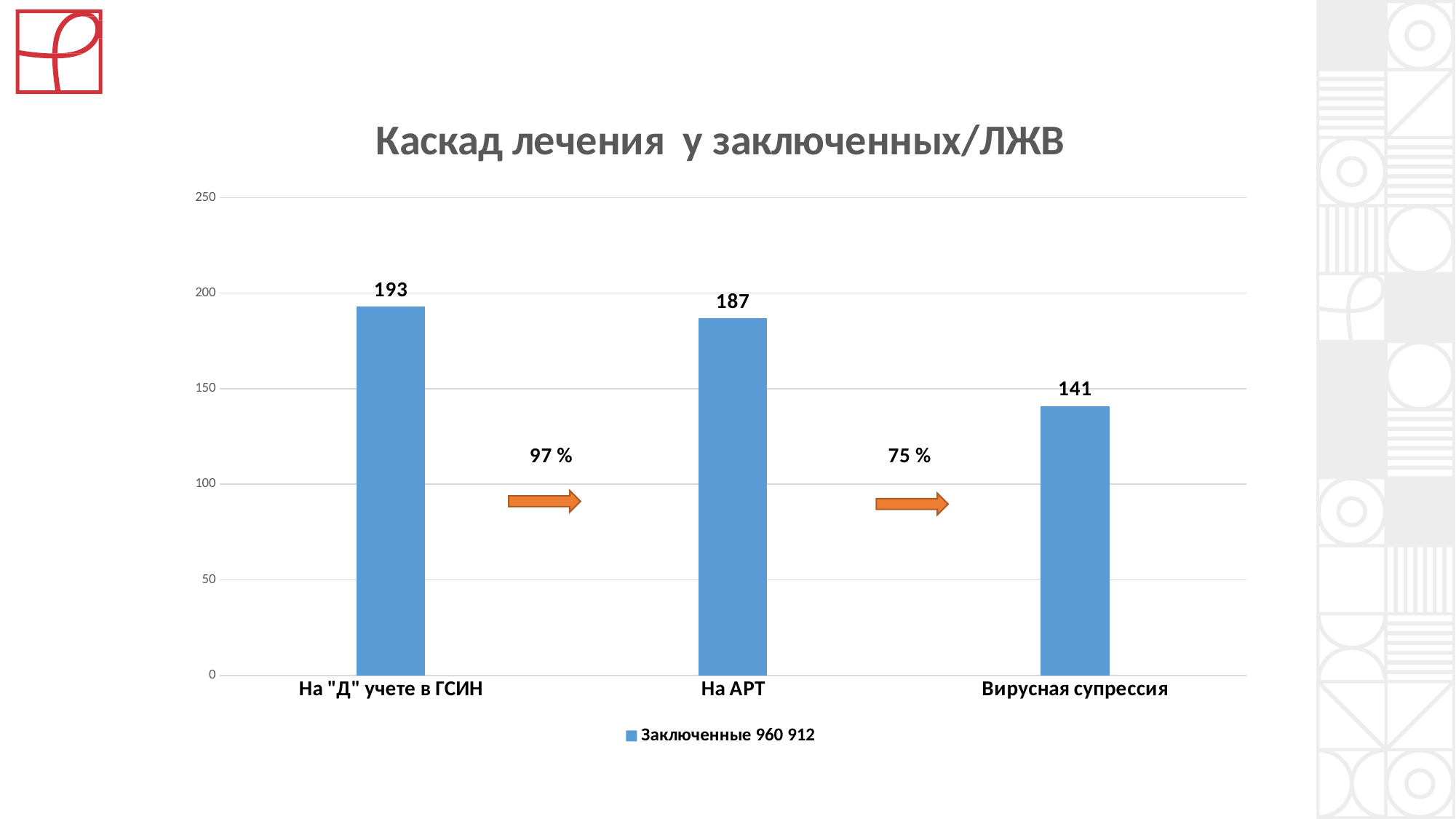
Which category has the lowest value? Вирусная супрессия What is the value for На "Д" учете в ГСИН? 193 What is the difference between the values for На АРТ and Вирусная супрессия? 46 How many categories are shown on the x axis? 3 What kind of chart is shown on the slide? bar chart What is the difference between the values for На "Д" учете в ГСИН and На АРТ? 6 Do the values rise or fall from left to right along the x axis? fall What is the value for На АРТ? 187 Which is larger, the value for На АРТ or the value for Вирусная супрессия? На АРТ Which category has the highest value? На "Д" учете в ГСИН Is the value for Вирусная супрессия greater or less than 150? less What is the value for Вирусная супрессия? 141